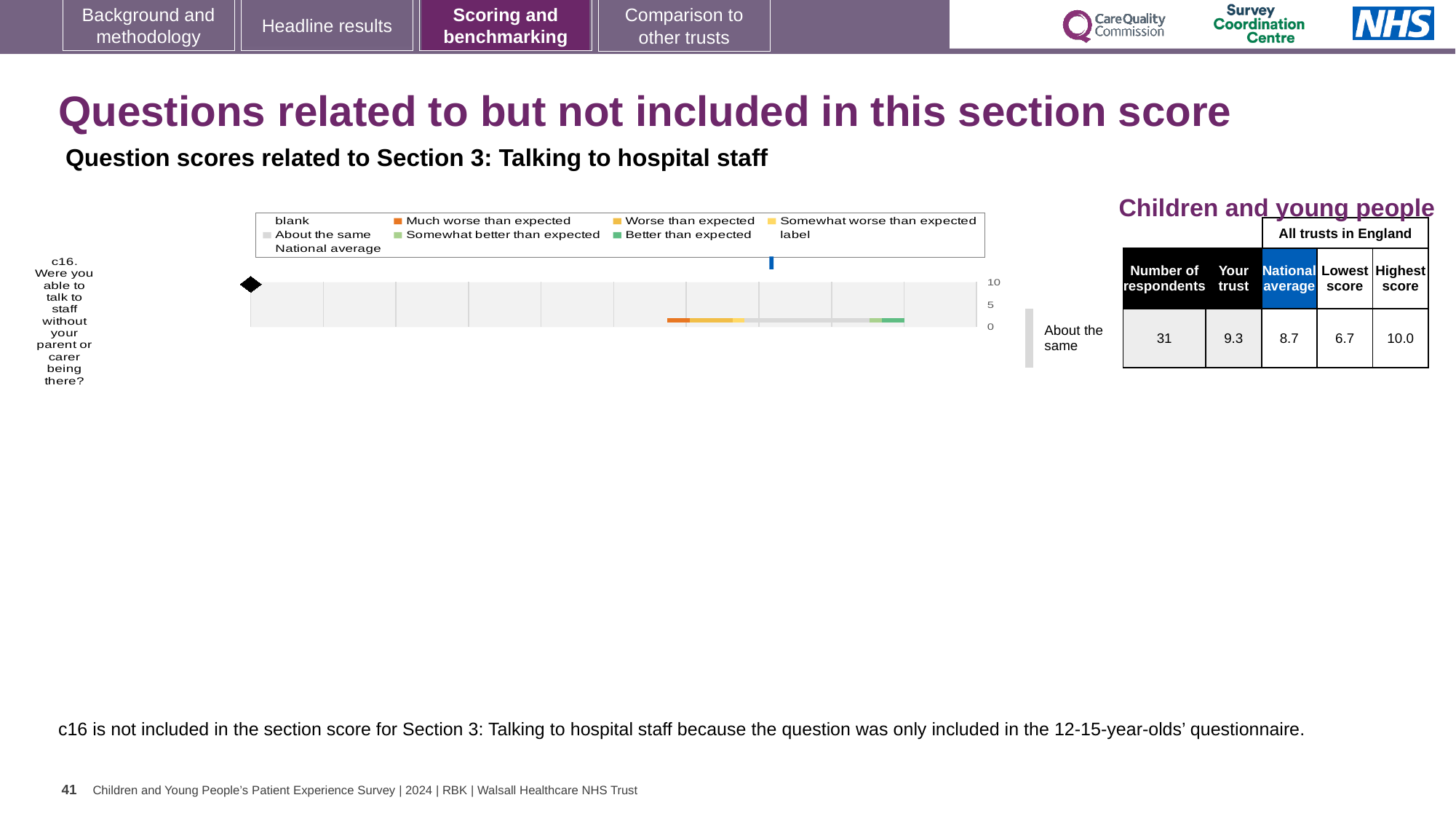
How many survey questions are plotted in the chart? 1 According to the table beside the chart, what is the highest score among all trusts in England for c16? 10.0 How many respondents answered c16 according to the table beside the chart? 31 According to the table beside the chart, what is the national average score for c16? 8.7 What colour does the chart legend use for 'Much worse than expected'? Orange What is the highest value shown on the chart's axis? 10 According to the table beside the chart, what is the 'Your trust' score for c16? 9.3 Which is larger for c16: the 'Your trust' score or the national average? Your trust Which question is plotted in the chart? c16. Were you able to talk to staff without your parent or carer being there? What kind of chart is used to show the c16 result on this slide? bar chart According to the table beside the chart, what is the lowest score among all trusts in England for c16? 6.7 What is the difference between the 'Your trust' score and the national average for c16? 0.6